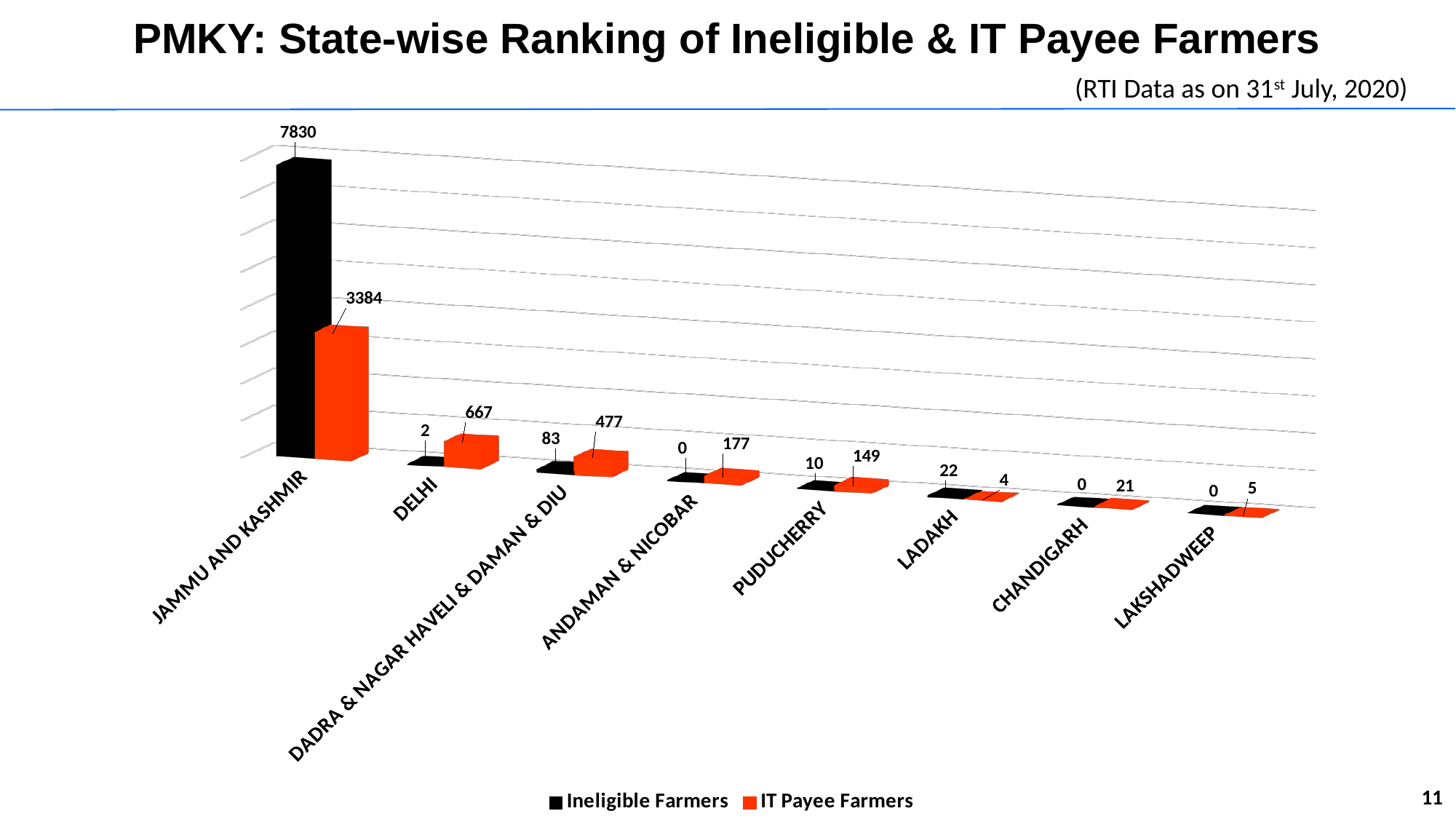
What is the value for IT Payee Farmers in Delhi? 667 How many states or territories are shown on the chart? 8 What is the value for Ineligible Farmers in Ladakh? 22 What is the value for IT Payee Farmers in Puducherry? 149 What is the difference between Ineligible Farmers and IT Payee Farmers in Jammu and Kashmir? 4446 Which state or territory has the highest value for IT Payee Farmers? Jammu and Kashmir What kind of chart is shown on the slide? Bar chart Which colour represents IT Payee Farmers in the chart? Orange What is the value for Ineligible Farmers in Jammu and Kashmir? 7830 Which state or territory has the lowest value for IT Payee Farmers? Ladakh How many series does the legend list? 2 Which is larger in Dadra & Nagar Haveli & Daman & Diu: Ineligible Farmers or IT Payee Farmers? IT Payee Farmers